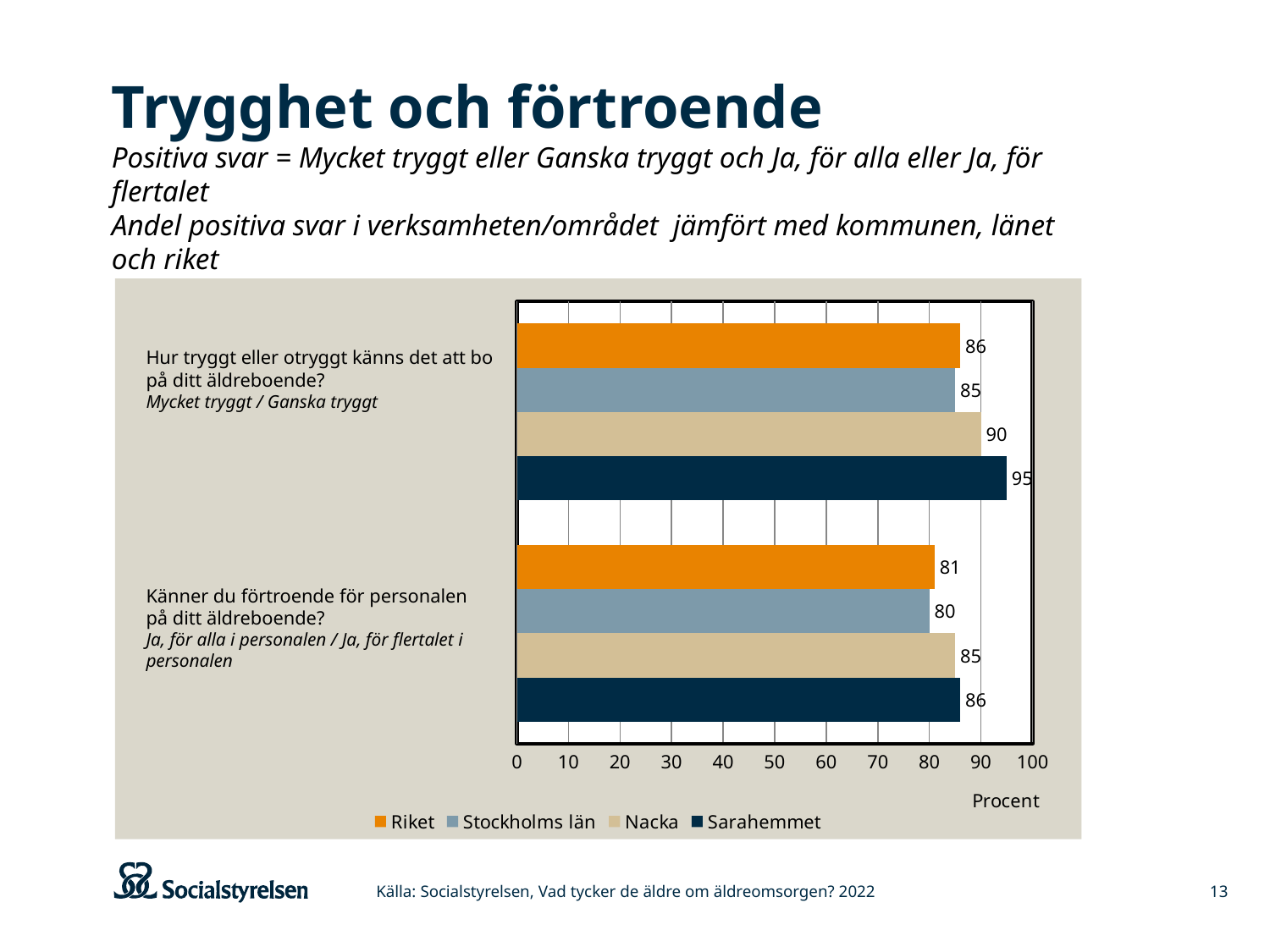
What is the difference between Nacka and Stockholms län on the question "Känner du förtroende för personalen på ditt äldreboende?"? 5 What is the value for Stockholms län on the question "Känner du förtroende för personalen på ditt äldreboende?"? 80 What is the value for Nacka on the question "Hur tryggt eller otryggt känns det att bo på ditt äldreboende?"? 90 Which series has the lowest value on the question "Känner du förtroende för personalen på ditt äldreboende?"? Stockholms län What is the label of the x axis? Procent Which is larger on the question "Hur tryggt eller otryggt känns det att bo på ditt äldreboende?": Nacka or Riket? Nacka What is the value for Sarahemmet on the question "Hur tryggt eller otryggt känns det att bo på ditt äldreboende?"? 95 How many series does the legend list? 4 What kind of chart is shown on the slide? Bar chart What is the difference between Sarahemmet and Riket on the question "Hur tryggt eller otryggt känns det att bo på ditt äldreboende?"? 9 What is the value for Riket on the question "Känner du förtroende för personalen på ditt äldreboende?"? 81 Which series has the highest value on the question "Hur tryggt eller otryggt känns det att bo på ditt äldreboende?"? Sarahemmet